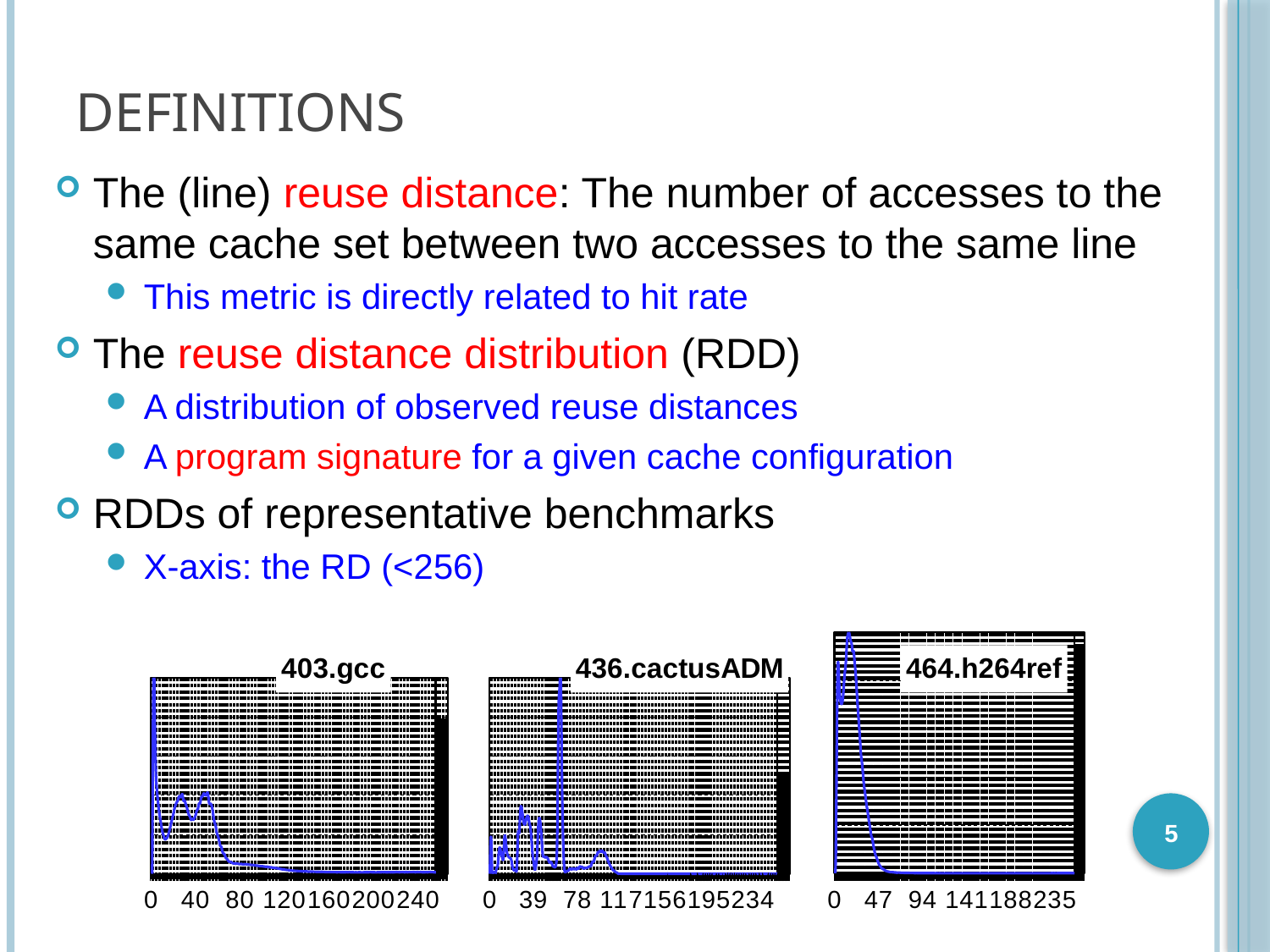
What is the title of the leftmost chart? 403.gcc How many charts are shown on the slide? 3 In the 436.cactusADM chart, what x-axis tick label follows 39? 78 What kind of chart is the 464.h264ref chart? line chart In the 436.cactusADM chart, what is the largest x-axis tick label shown? 234 What kind of chart is the 403.gcc chart? line chart In the 464.h264ref chart, how many x-axis tick labels are shown? 6 What is the title of the middle chart? 436.cactusADM In the 464.h264ref chart, what is the largest x-axis tick label shown? 235 In the 403.gcc chart, what is the largest x-axis tick label shown? 240 In the 403.gcc chart, how many x-axis tick labels are shown? 7